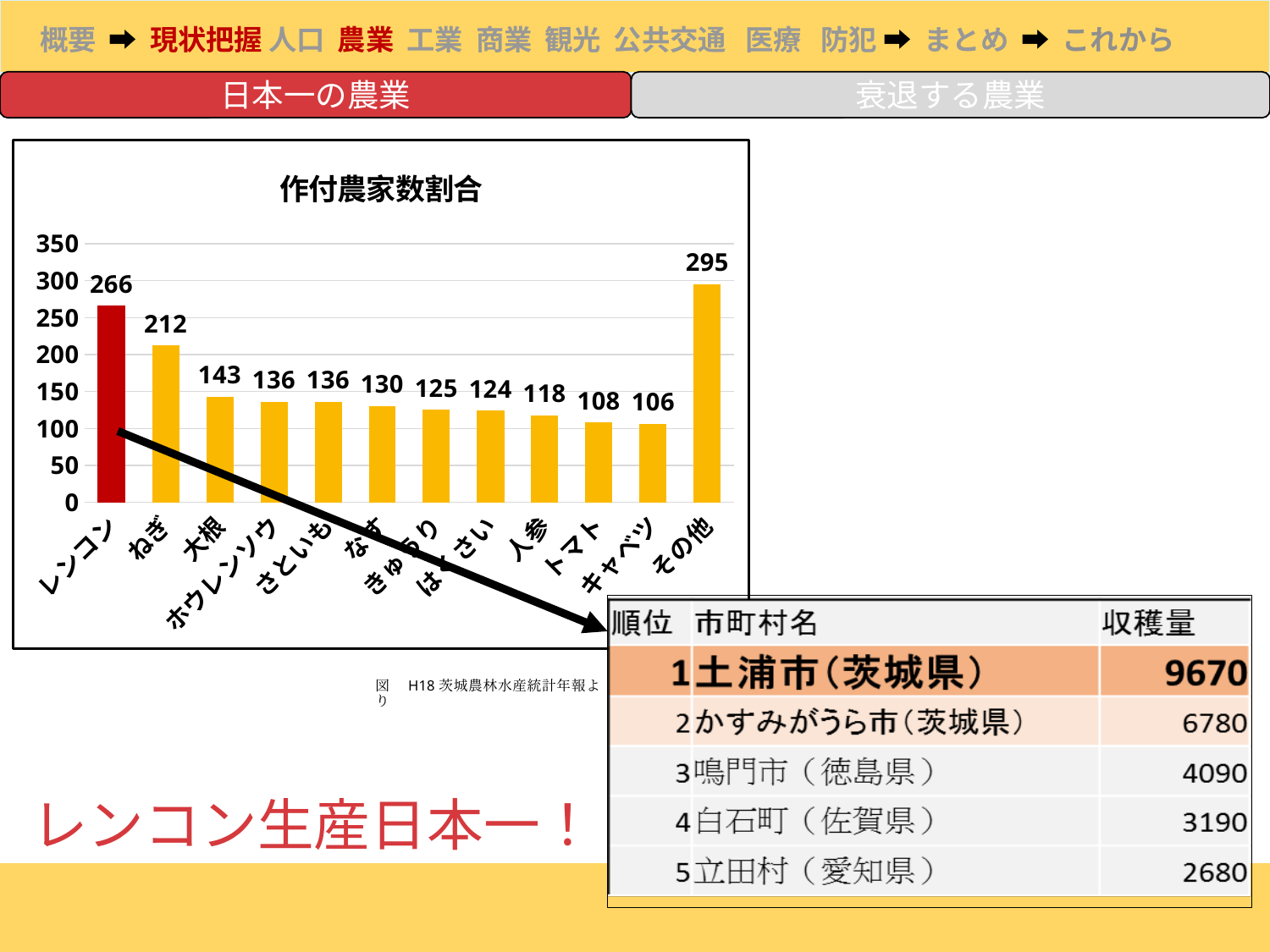
Which bar in the 作付農家数割合 chart is coloured red instead of orange? レンコン What is the value for キャベツ in the 作付農家数割合 chart? 106 What is the difference between the values for レンコン and ねぎ in the 作付農家数割合 chart? 54 How many categories are shown on the x axis of the 作付農家数割合 chart? 12 What kind of chart is the 作付農家数割合 chart? Bar chart What is the difference between the values for その他 and レンコン in the 作付農家数割合 chart? 29 Which category has the lowest value in the 作付農家数割合 chart? キャベツ What is the value for その他 in the 作付農家数割合 chart? 295 Which category has the highest value in the 作付農家数割合 chart? その他 What is the value for レンコン in the 作付農家数割合 chart? 266 Which is larger in the 作付農家数割合 chart, the value for 大根 or the value for トマト? 大根 What is the value for ねぎ in the 作付農家数割合 chart? 212